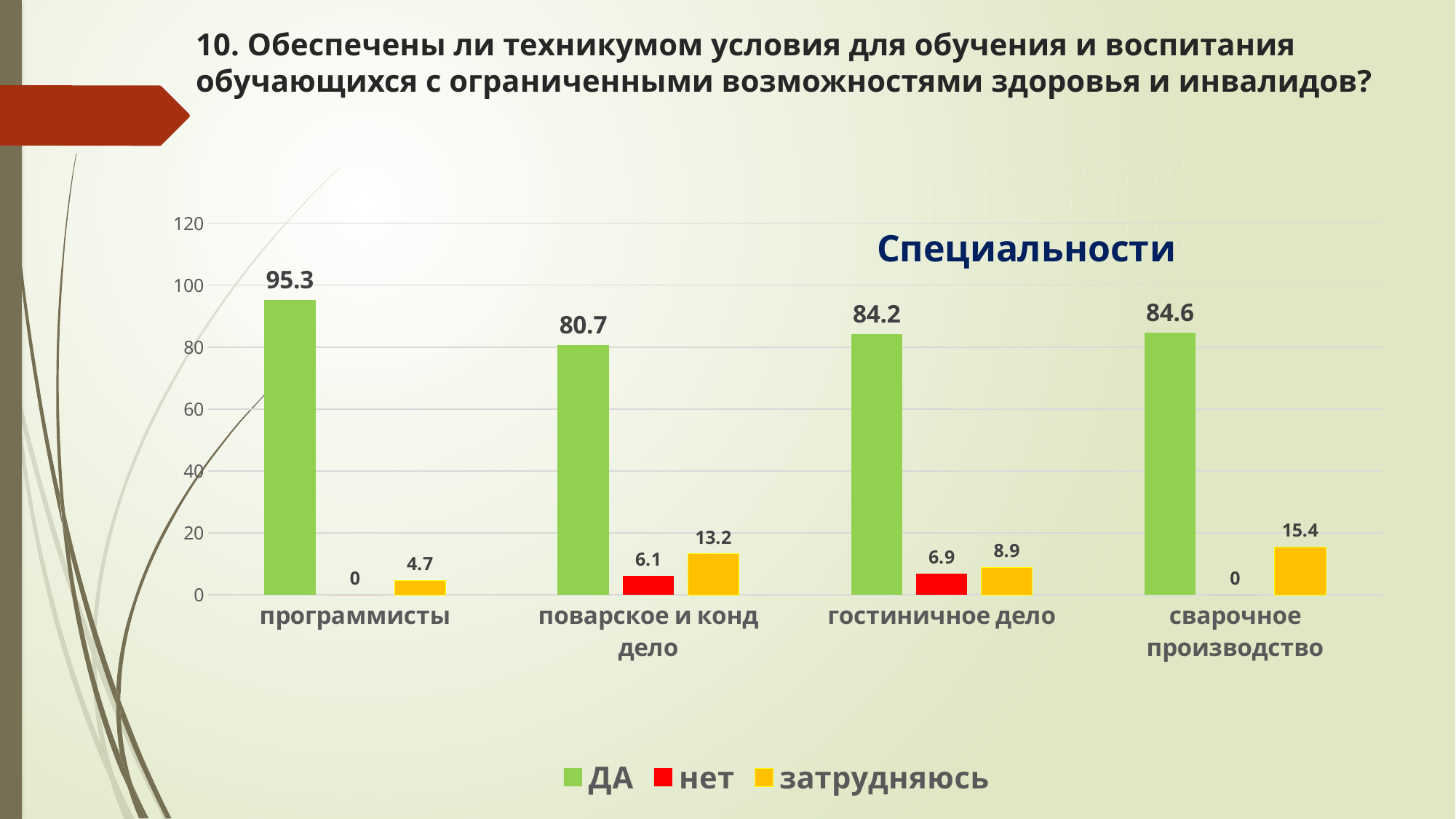
What is the value of the ДА series for программисты? 95.3 Which is larger: the затрудняюсь value for поварское и конд дело or for гостиничное дело? поварское и конд дело How many categories are shown on the x axis? 4 Which category has the lowest value in the ДА series? поварское и конд дело Is the ДА value for сварочное производство greater or less than 80? greater What is the difference between the ДА values for программисты and поварское и конд дело? 14.6 What is the value of the нет series for гостиничное дело? 6.9 What colour represents the нет series in the chart? red How many series does the legend list? 3 Which category has the highest value in the ДА series? программисты What is the value of the затрудняюсь series for сварочное производство? 15.4 What kind of chart is shown on the slide? bar chart